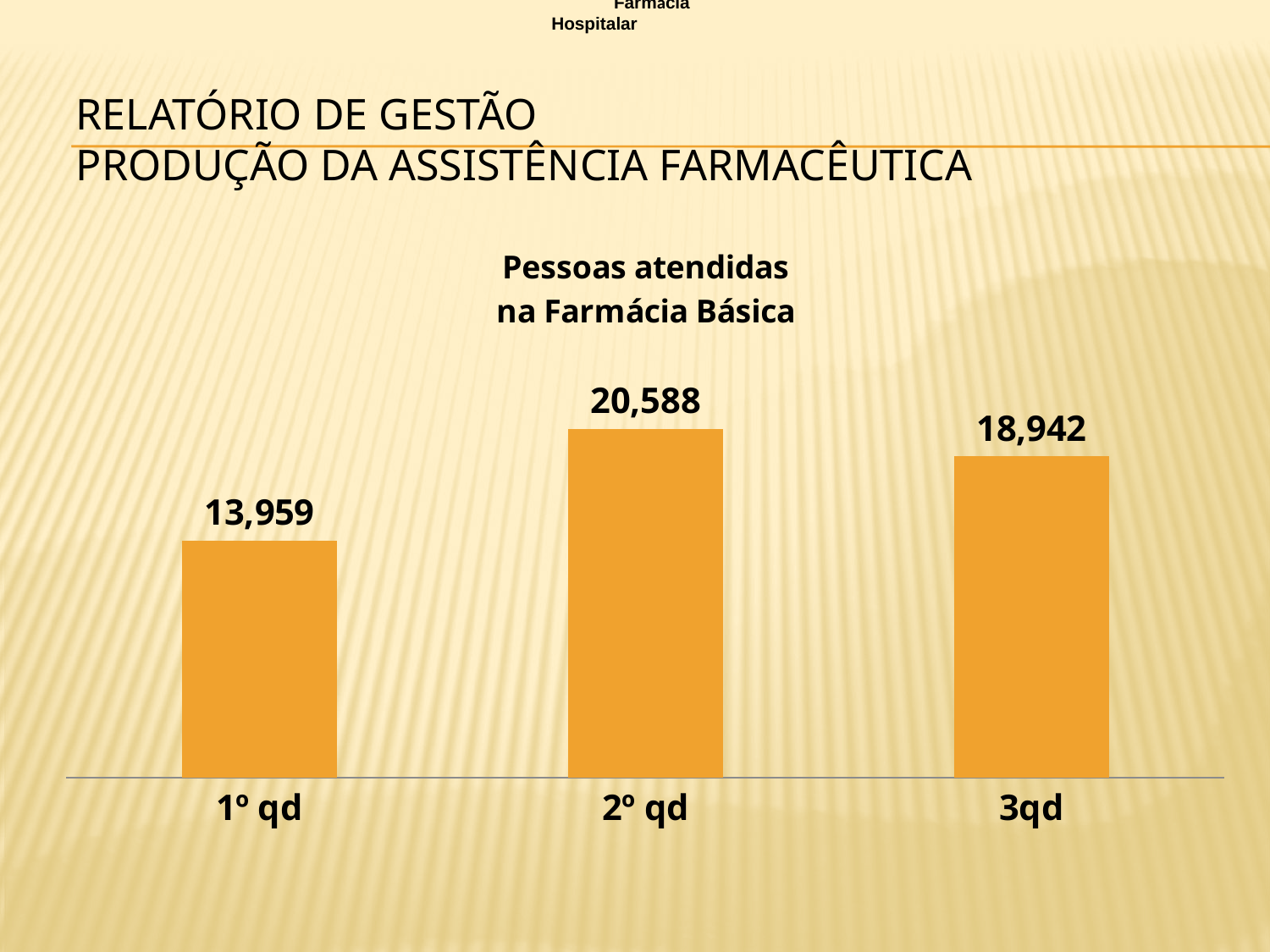
What is the title of the chart? Pessoas atendidas na Farmácia Básica What is the difference between the values for 2º qd and 1º qd? 6,629 What colour are the bars in the chart? orange Which category has the highest value? 2º qd What is the difference between the values for 2º qd and 3qd? 1,646 What is the value for 2º qd? 20,588 Which is larger, the value for 3qd or the value for 1º qd? 3qd How many categories are shown in the chart? 3 What is the value for 1º qd? 13,959 What kind of chart is shown on the slide? bar chart Which category has the lowest value? 1º qd What is the value for 3qd? 18,942